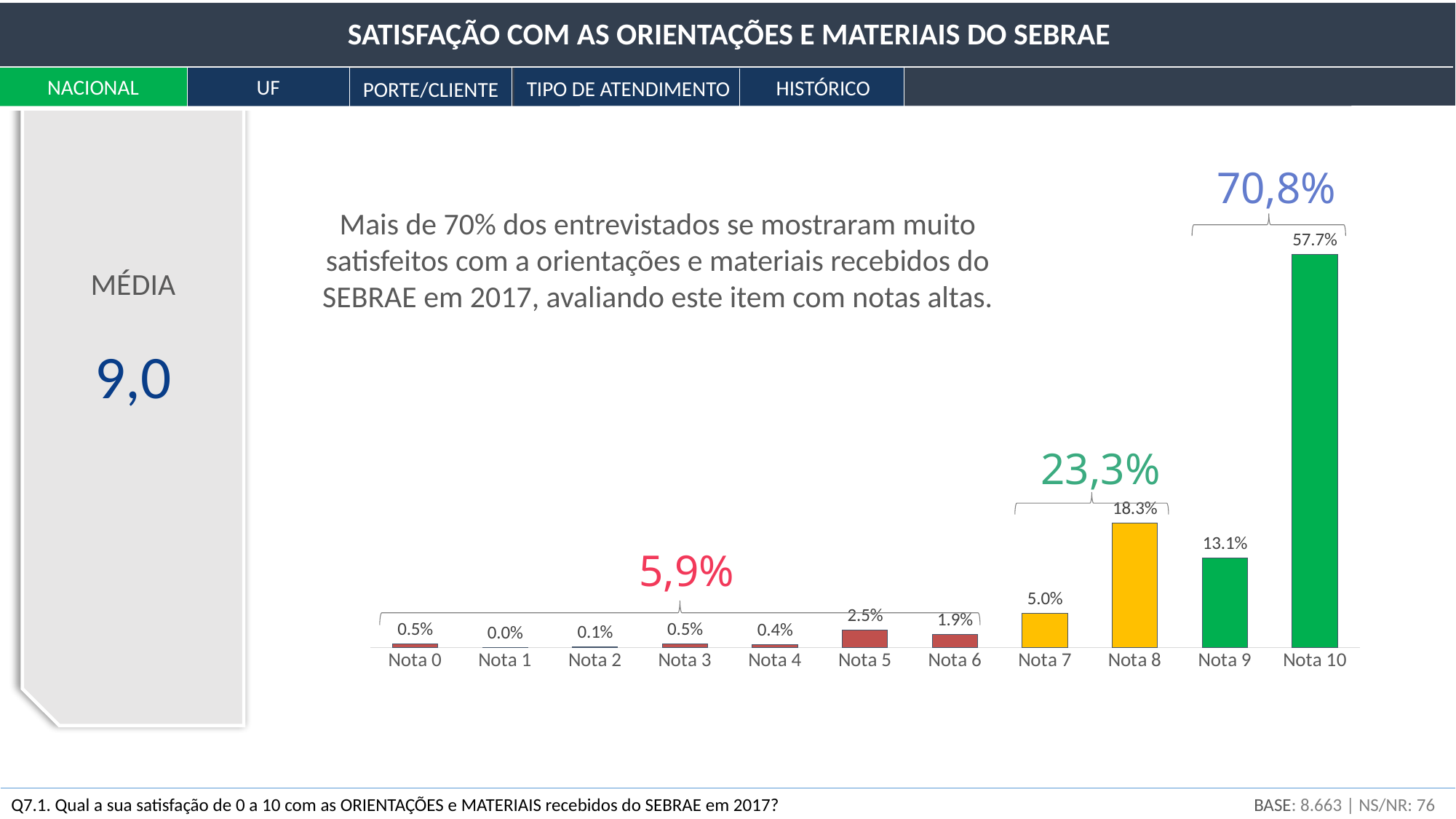
What is the value for Nota 10? 57.7% What combined percentage is shown above the bracket grouping Nota 9 and Nota 10? 70,8% What is the value for Nota 5? 2.5% What is the difference between the values for Nota 10 and Nota 8? 39.4% How many categories are shown on the x axis? 11 What kind of chart is shown on the slide? bar chart Which category has the lowest value? Nota 1 Which is larger, the value for Nota 7 or the value for Nota 9? Nota 9 What is the difference between the values for Nota 8 and Nota 9? 5.2% What is the value for Nota 1? 0.0% What is the value for Nota 8? 18.3% Which category has the highest value? Nota 10